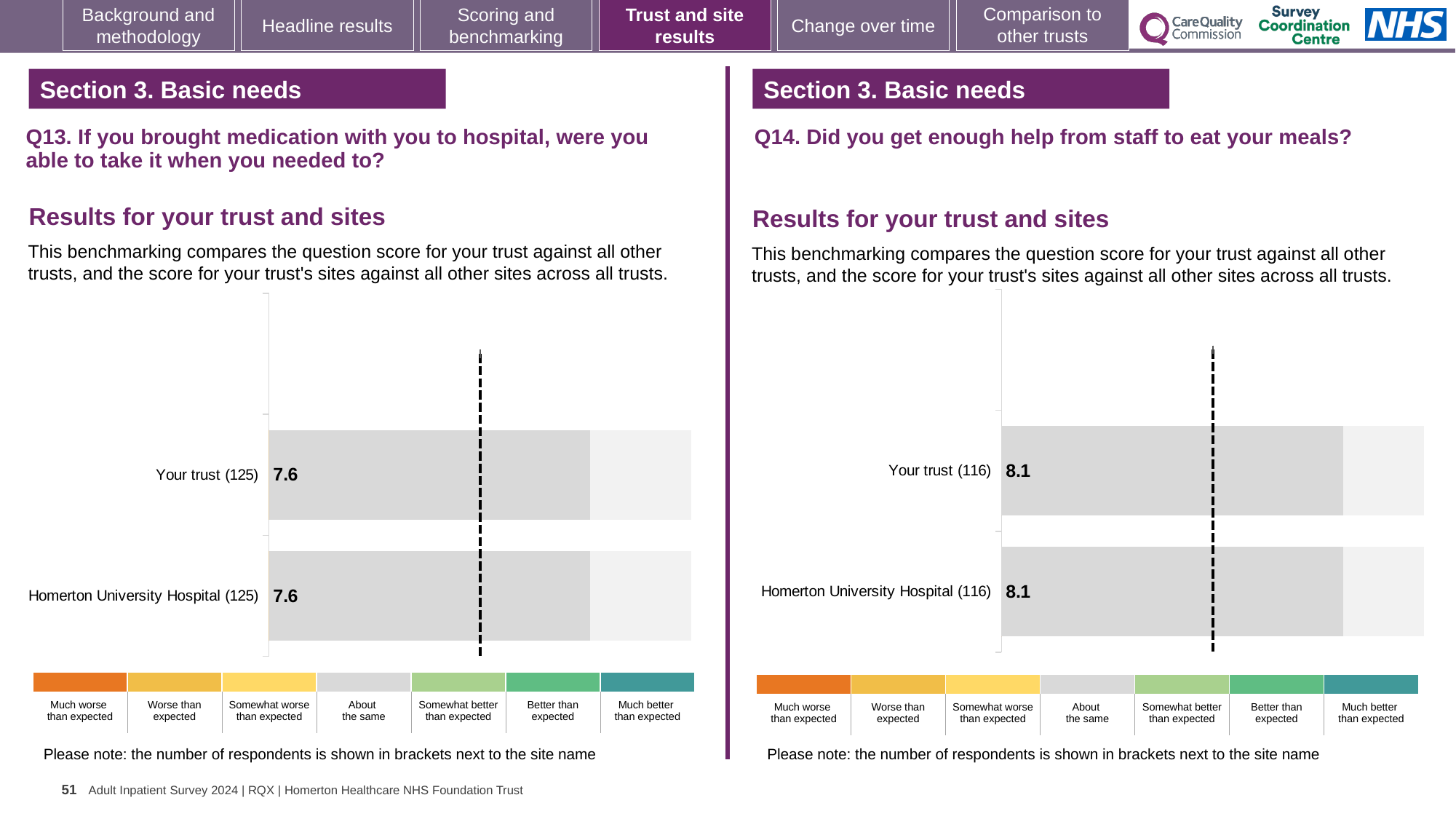
How many bars are plotted in the Q13 chart on the left? 2 In the Q13 chart on the left, what is the difference between the Your trust score and the Homerton University Hospital score? 0 In the Q13 chart on the left, what is the score for Your trust? 7.6 In the Q13 chart on the left, how many respondents are shown in brackets next to Your trust? 125 What kind of chart is used for the Q13 results on the left? Bar chart In the Q14 chart on the right, how many respondents are shown in brackets next to Homerton University Hospital? 116 In the Q13 chart on the left, what is the score for Homerton University Hospital? 7.6 What is the difference between the Your trust score in the Q14 chart and the Your trust score in the Q13 chart? 0.5 In the Q14 chart on the right, what is the score for Homerton University Hospital? 8.1 How many bars are plotted in the Q14 chart on the right? 2 In the Q14 chart on the right, what is the score for Your trust? 8.1